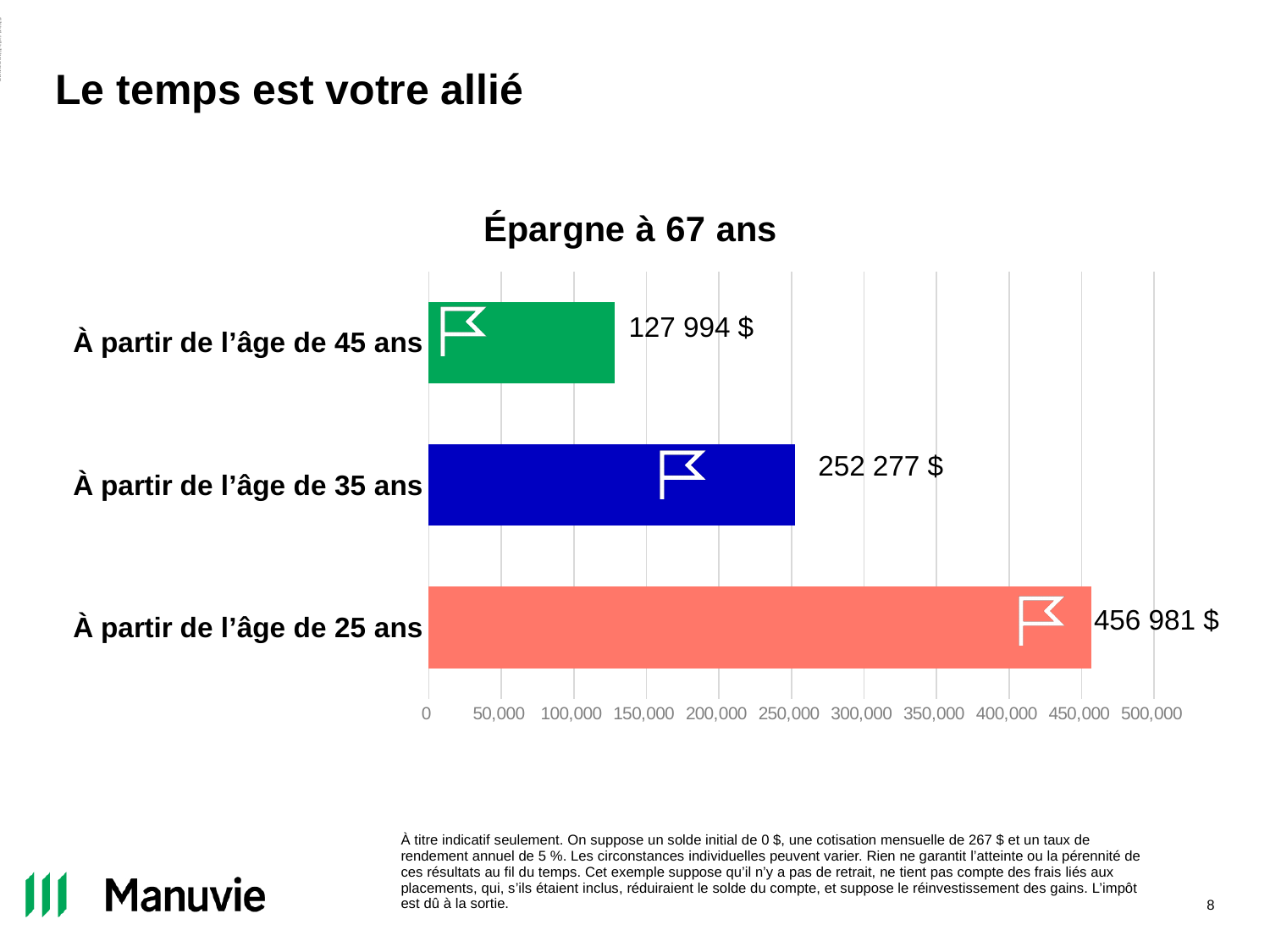
Which is larger, the value for "À partir de l’âge de 35 ans" or "À partir de l’âge de 45 ans"? À partir de l’âge de 35 ans What is the value for "À partir de l’âge de 25 ans"? 456 981 $ What is the difference between the values for "À partir de l’âge de 25 ans" and "À partir de l’âge de 45 ans"? 328 987 $ Is the value for "À partir de l’âge de 25 ans" greater or less than 400,000? greater How many categories are shown in the chart? 3 Which category has the lowest value? À partir de l’âge de 45 ans What is the title of the chart? Épargne à 67 ans What kind of chart is shown on the slide? bar chart What is the value for "À partir de l’âge de 35 ans"? 252 277 $ Which category has the highest value? À partir de l’âge de 25 ans What is the value for "À partir de l’âge de 45 ans"? 127 994 $ What is the difference between the values for "À partir de l’âge de 35 ans" and "À partir de l’âge de 45 ans"? 124 283 $